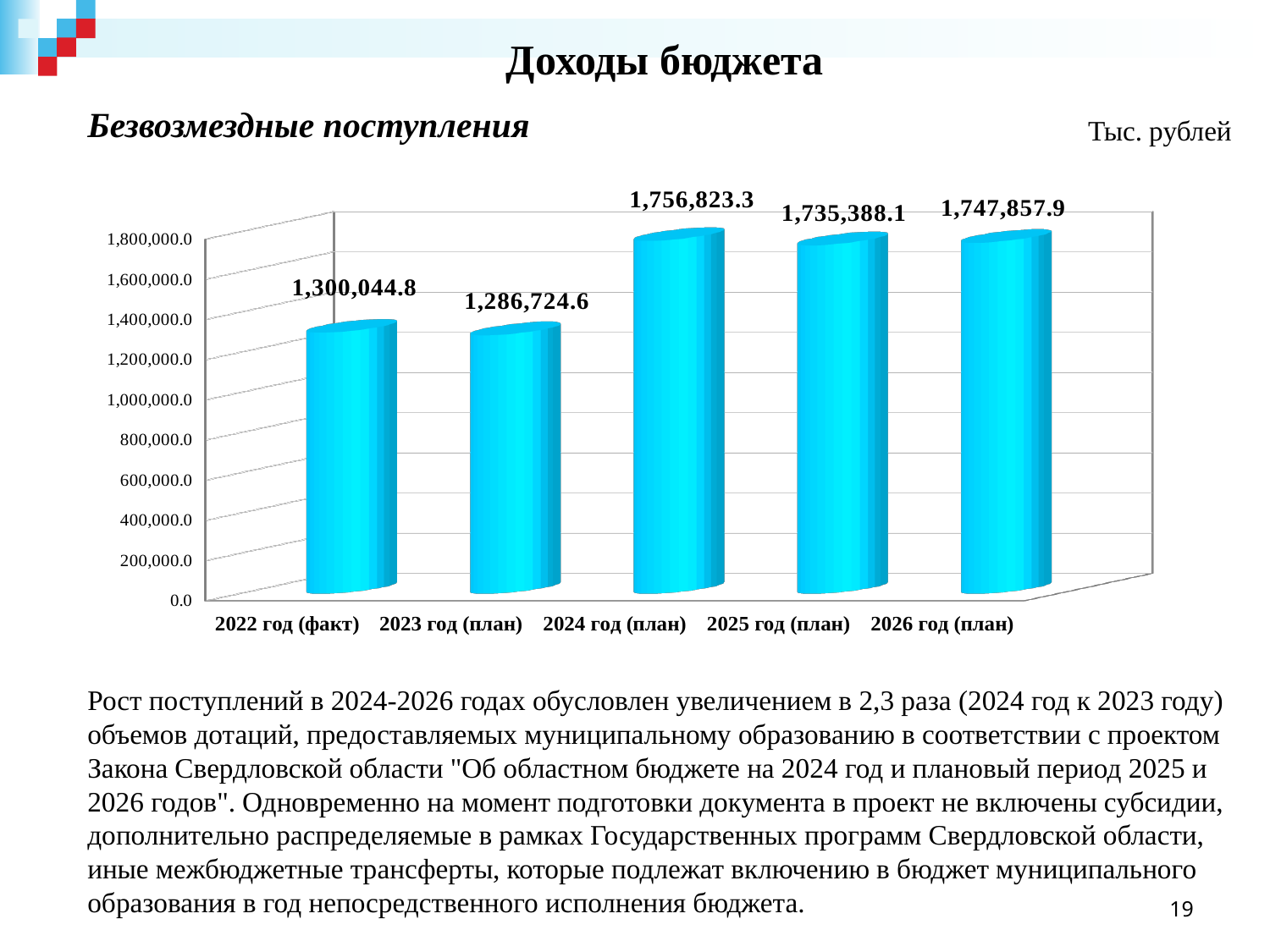
What is the difference between the values for 2022 год (факт) and 2023 год (план)? 13,320.2 What is the difference between the values for 2024 год (план) and 2023 год (план)? 470,098.7 What is the value for 2024 год (план)? 1,756,823.3 How many categories are shown on the x axis? 5 Which category has the highest value? 2024 год (план) What unit of measurement is stated for the chart? Тыс. рублей What is the value for 2022 год (факт)? 1,300,044.8 What is the value for 2026 год (план)? 1,747,857.9 What kind of chart is shown on the slide? bar chart Is the value for 2022 год (факт) greater or less than 1,200,000.0? greater Which category has the lowest value? 2023 год (план) Which is larger, the value for 2025 год (план) or 2026 год (план)? 2026 год (план)